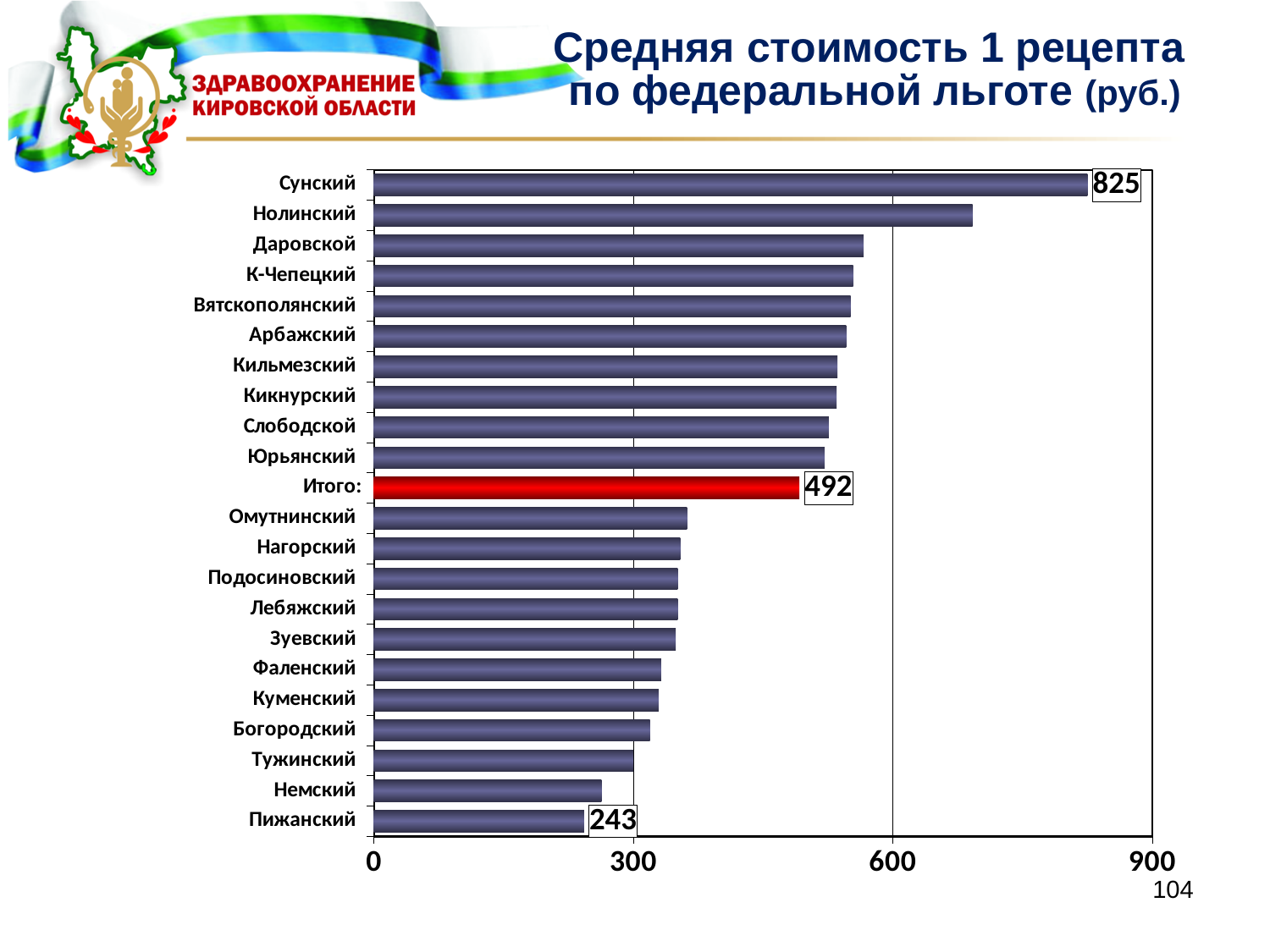
What is the difference between the values for Сунский and Итого:? 333 Is the value for Немский greater or less than 300? less What is the value for Пижанский? 243 Which has a larger value, Нолинский or Даровской? Нолинский What is the difference between the values for Сунский and Пижанский? 582 How many categories (bars) are shown in the chart? 22 Which category has the lowest value? Пижанский What kind of chart is shown on the slide? bar chart What is the value for Итого:? 492 Which category has the highest value? Сунский Is the value for Нолинский greater or less than 600? greater What is the value for Сунский? 825